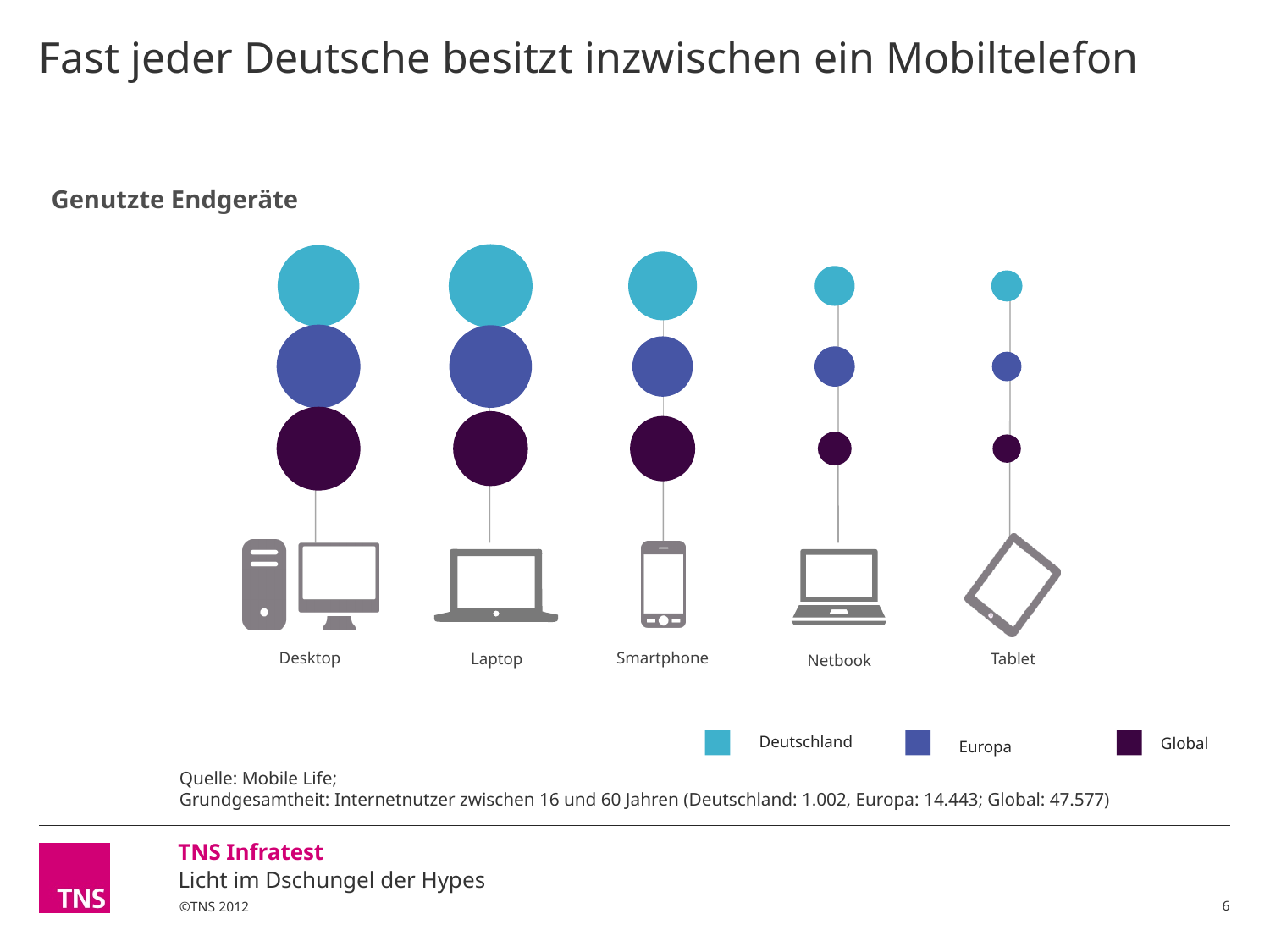
What is the title of the chart? Genutzte Endgeräte For Deutschland, which is larger: the bubble for Desktop or the bubble for Tablet? Desktop Do the bubble sizes for Deutschland rise or fall moving from Desktop to Tablet along the x axis? fall How many series does the legend list? 3 Which series are listed in the legend? Deutschland, Europa, Global For Europa, which is larger: the bubble for Smartphone or the bubble for Tablet? Smartphone For Deutschland, which is larger: the bubble for Smartphone or the bubble for Netbook? Smartphone Do the bubble sizes for Global rise or fall moving from Laptop to Tablet along the x axis? fall How many device categories are shown in the chart? 5 What kind of chart is shown on the slide? bubble chart